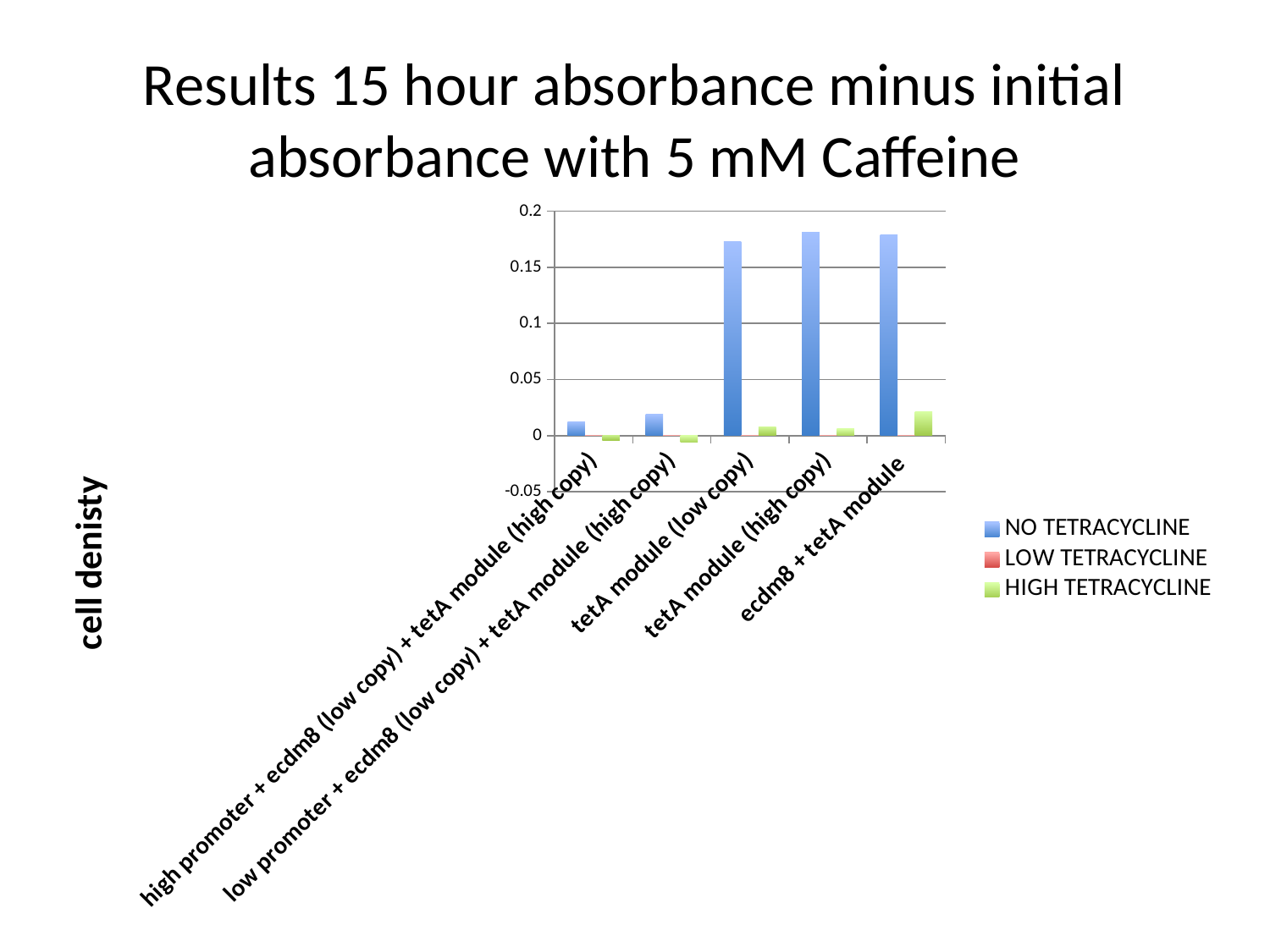
Which category has the highest HIGH TETRACYCLINE value? ecdm8 + tetA module How many categories are shown on the x axis? 5 Is the HIGH TETRACYCLINE value for ecdm8 + tetA module greater or less than 0.05? less Which is larger, the NO TETRACYCLINE value for tetA module (low copy) or the NO TETRACYCLINE value for low promoter + ecdm8 (low copy) + tetA module (high copy)? tetA module (low copy) Which series is shown in green in the legend? HIGH TETRACYCLINE How many series does the legend list? 3 What is the label on the vertical axis of the chart? cell denisty Is the NO TETRACYCLINE value for ecdm8 + tetA module greater or less than 0.15? greater What kind of chart is shown on the slide? bar chart Is the NO TETRACYCLINE value for tetA module (low copy) greater or less than 0.15? greater Which is larger, the HIGH TETRACYCLINE value for high promoter + ecdm8 (low copy) + tetA module (high copy) or for tetA module (low copy)? tetA module (low copy)